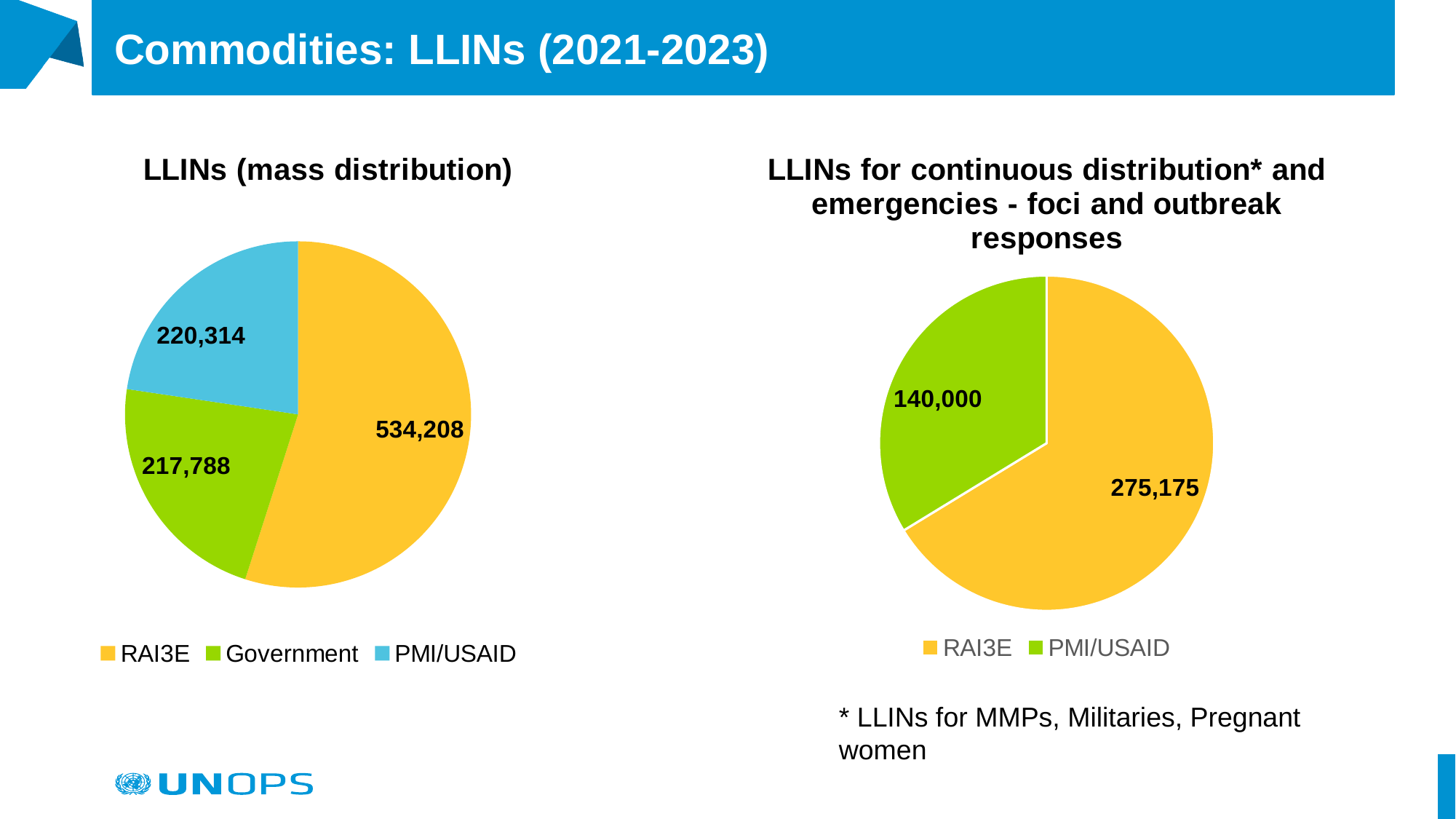
In the LLINs for continuous distribution and emergencies chart, which category has the smallest slice? PMI/USAID In the LLINs (mass distribution) chart, what is the total of all three slices? 972,310 In the LLINs for continuous distribution and emergencies chart, what is the value for PMI/USAID? 140,000 In the LLINs (mass distribution) chart, what is the value for Government? 217,788 In the LLINs (mass distribution) chart, what is the difference between the RAI3E and PMI/USAID values? 313,894 In the LLINs (mass distribution) chart, which category has the largest slice? RAI3E In the LLINs (mass distribution) chart, what is the value for RAI3E? 534,208 In the LLINs for continuous distribution and emergencies chart, what is the difference between the RAI3E and PMI/USAID values? 135,175 What type of chart is the LLINs for continuous distribution and emergencies chart? Pie chart In the LLINs for continuous distribution and emergencies chart, what is the value for RAI3E? 275,175 In the LLINs (mass distribution) chart, how many categories are shown? 3 In the LLINs (mass distribution) chart, what is the value for PMI/USAID? 220,314